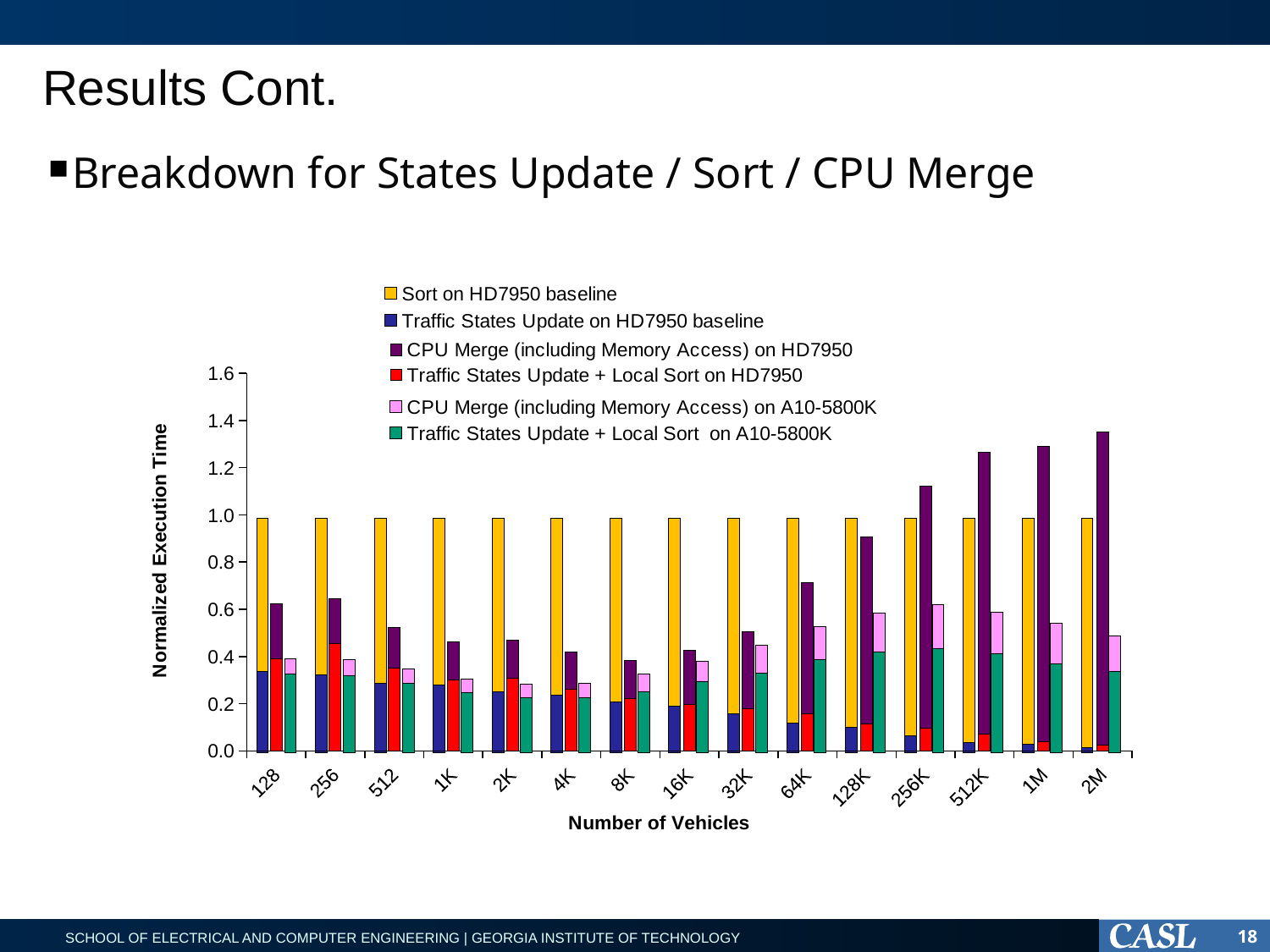
At which number of vehicles is the HD7950 stacked bar (Traffic States Update + Local Sort + CPU Merge) the tallest? 2M Is the total of the HD7950 stacked bar (Traffic States Update + Local Sort + CPU Merge) at 2M vehicles greater or less than 1.2? greater What is the label of the x axis? Number of Vehicles At 2M vehicles, which stacked bar is taller: the HD7950 bar (with CPU Merge) or the A10-5800K bar (with CPU Merge)? HD7950 How many vehicle-count categories are shown on the x axis? 15 What kind of chart is shown on the slide? stacked bar chart What is the label of the y axis? Normalized Execution Time From 32K to 2M vehicles, does the height of the HD7950 stacked bar (with CPU Merge) rise or fall? rise Is the total of the HD7950 stacked bar (Traffic States Update + Local Sort + CPU Merge) at 128 vehicles greater or less than 0.8? less Is the total of the A10-5800K stacked bar at 128 vehicles greater or less than 0.6? less How many series does the legend list? 6